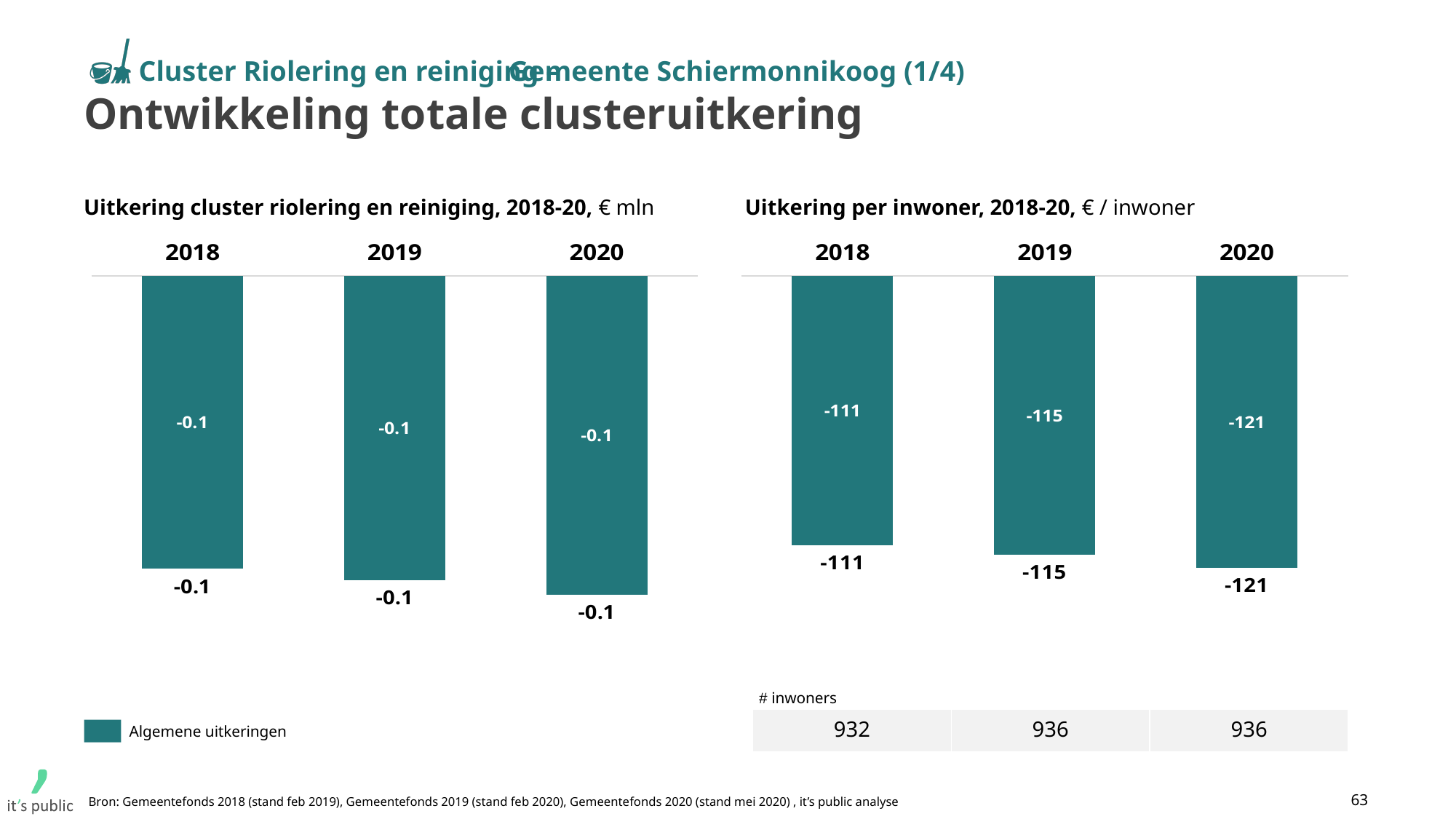
In the chart 'Uitkering per inwoner, 2018-20', which year has the lowest (most negative) value? 2020 How many series does the legend on the slide list? 1 In the chart 'Uitkering cluster riolering en reiniging, 2018-20', what is the value for 2019? -0.1 How many years are shown in the chart 'Uitkering cluster riolering en reiniging, 2018-20'? 3 In the chart 'Uitkering per inwoner, 2018-20', what is the value for 2020? -121 In the chart 'Uitkering per inwoner, 2018-20', what is the difference between the 2018 value and the 2020 value? 10 In the chart 'Uitkering per inwoner, 2018-20', do the values rise or fall from 2018 to 2020? fall In the chart 'Uitkering per inwoner, 2018-20', what is the value for 2019? -115 In the chart 'Uitkering per inwoner, 2018-20', which year has the highest (least negative) value? 2018 What is the name of the series shown in the legend on the slide? Algemene uitkeringen In the chart 'Uitkering per inwoner, 2018-20', what is the value for 2018? -111 What kind of chart is 'Uitkering per inwoner, 2018-20'? bar chart